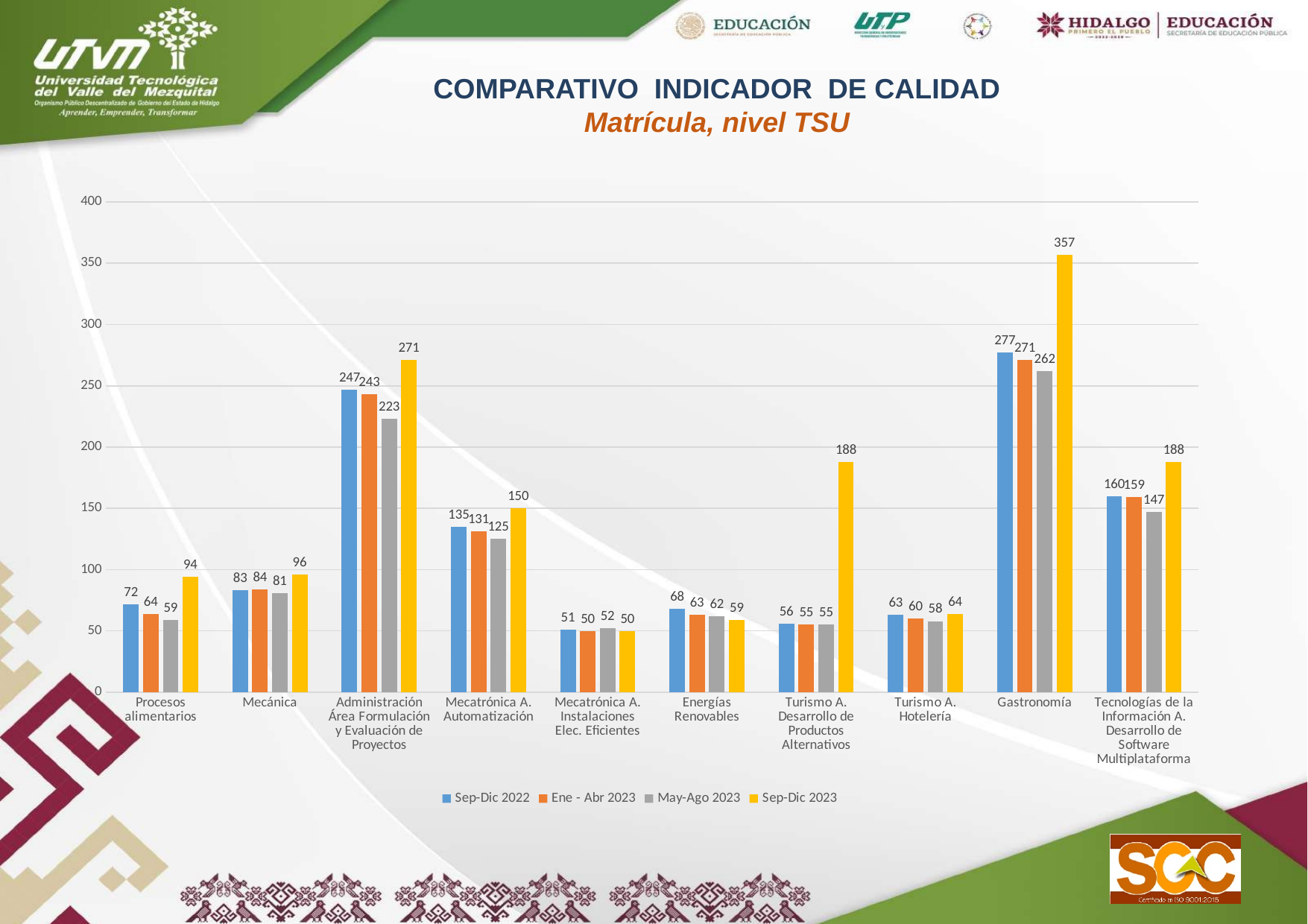
What is the Sep-Dic 2022 value for Mecatrónica A. Automatización? 135 Is the Sep-Dic 2023 value for Tecnologías de la Información A. Desarrollo de Software Multiplataforma greater or less than 150? greater What is the difference between the Sep-Dic 2023 and Sep-Dic 2022 values for Turismo A. Desarrollo de Productos Alternativos? 132 Which category has the highest Sep-Dic 2023 value? Gastronomía Which is larger for Energías Renovables: the Sep-Dic 2022 value or the Sep-Dic 2023 value? Sep-Dic 2022 What kind of chart is shown on the slide? Bar chart What is the May-Ago 2023 value for Administración Área Formulación y Evaluación de Proyectos? 223 Which series is shown in yellow in the legend? Sep-Dic 2023 Which category has the lowest Ene - Abr 2023 value? Mecatrónica A. Instalaciones Elec. Eficientes How many series does the legend list? 4 How many categories are shown on the x axis? 10 What is the Sep-Dic 2023 value for Gastronomía? 357